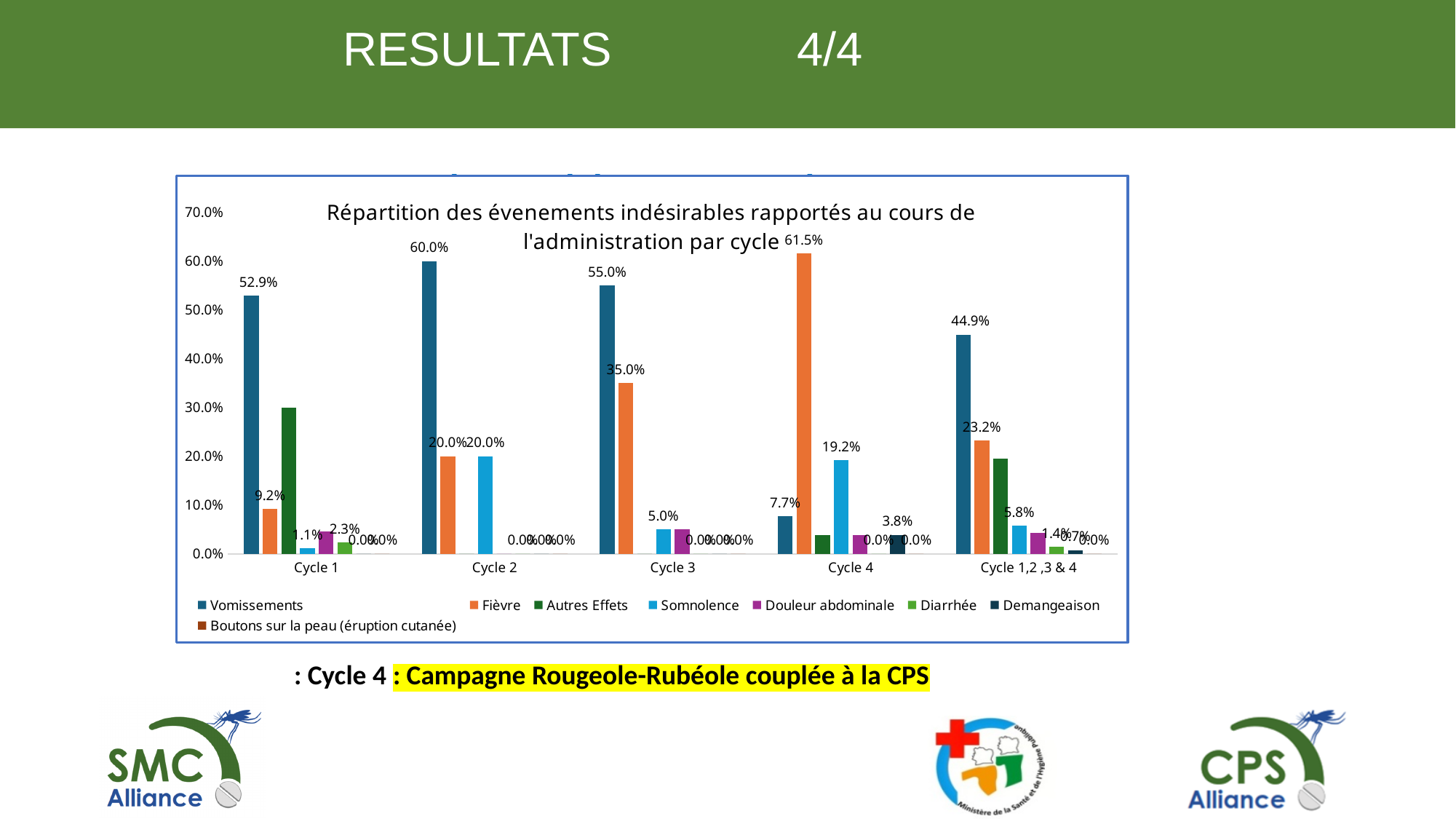
Is the value for Autres Effets in Cycle 1 greater or less than 20.0%? greater In Cycle 4, which is larger: Vomissements or Fièvre? Fièvre What is the value for Vomissements in Cycle 1? 52.9% What is the value for Fièvre in Cycle 4? 61.5% What kind of chart is shown on the slide? bar chart In which cycle category is the Vomissements value highest? Cycle 2 What is the value for Somnolence in Cycle 4? 19.2% What is the difference between the Vomissements values for Cycle 2 and Cycle 1? 7.1% How many series does the legend list? 8 What is the value for Vomissements in Cycle 1,2 ,3 & 4? 44.9% How many cycle categories are shown on the x axis? 5 What is the difference between the Fièvre values for Cycle 3 and Cycle 2? 15.0%